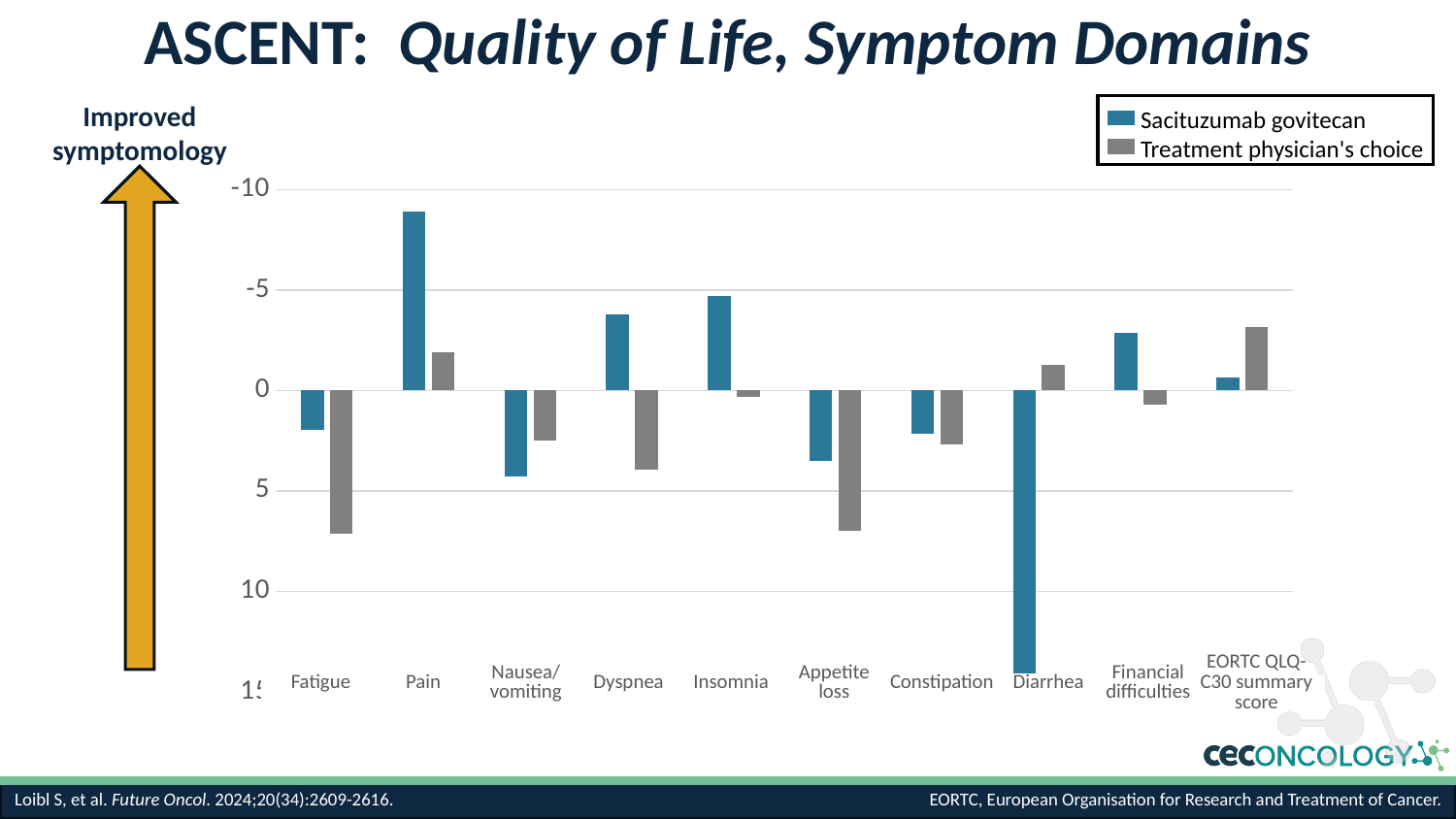
What are the two series named in the legend? Sacituzumab govitecan; Treatment physician's choice How many series does the legend list? 2 Is the Treatment physician's choice value for Fatigue greater or less than 5? greater Which category has the bar extending furthest upward (most negative value) for Sacituzumab govitecan? Pain How many symptom domain categories are shown on the x axis? 10 What kind of chart is shown on the slide? bar chart Is the Sacituzumab govitecan value for Diarrhea greater or less than 10? greater For Fatigue, which series has the larger value: Sacituzumab govitecan or Treatment physician's choice? Treatment physician's choice Which category has the tallest bar extending downward (largest positive value) for Sacituzumab govitecan? Diarrhea Is the Sacituzumab govitecan value for Pain greater or less than -5? less For Dyspnea, which series has the larger value: Sacituzumab govitecan or Treatment physician's choice? Treatment physician's choice What does the arrow on the left of the chart indicate the upward direction means? Improved symptomology